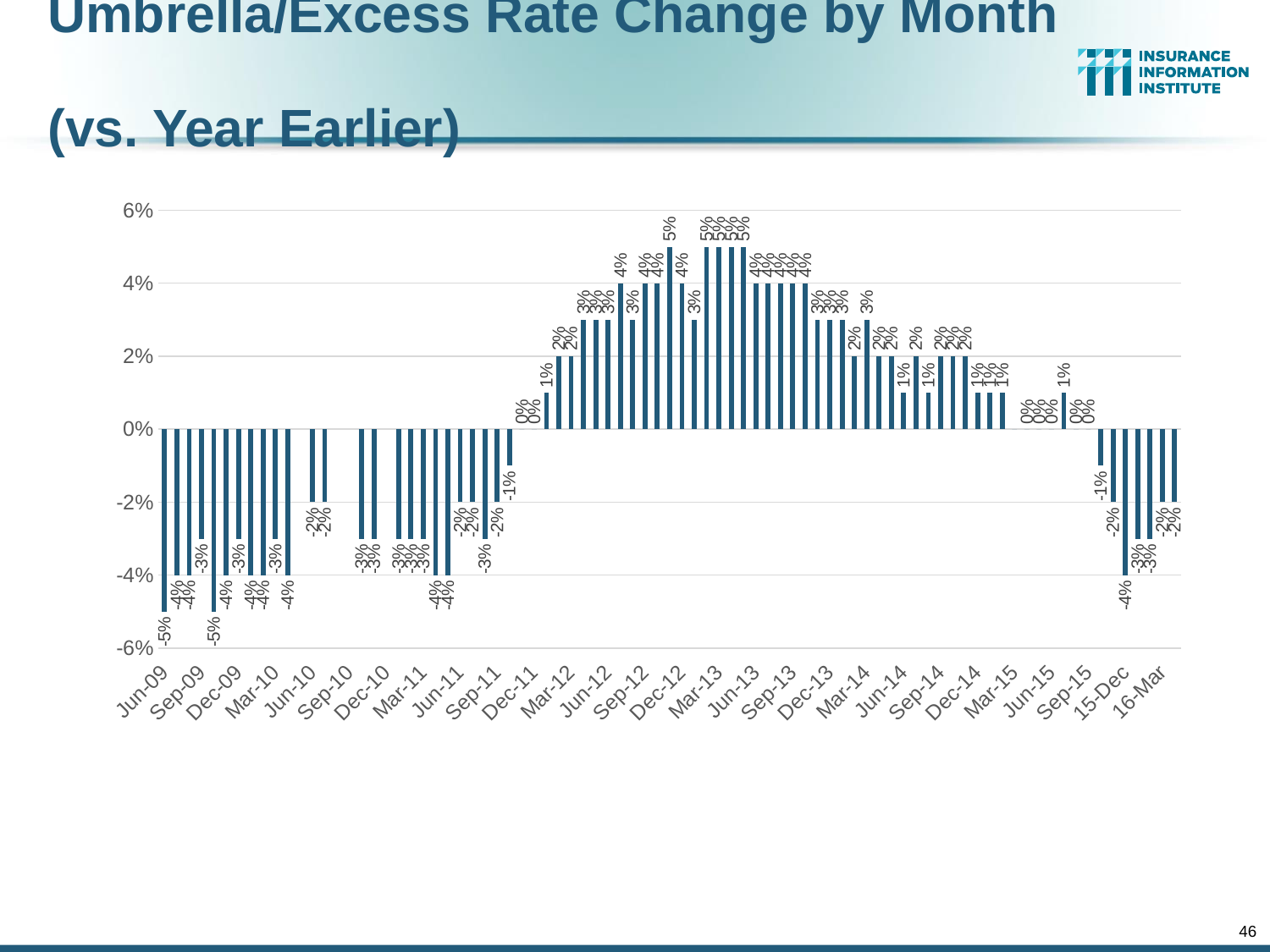
What are the minimum and maximum values shown on the vertical axis? -6% and 6% What is the rate change shown for Jun-09, the first bar on the chart? -5% What is the rate change shown for 16-Mar, the last bar on the chart? -2% Which has the larger rate change, Jun-09 or 16-Mar? 16-Mar What is the lowest rate change value labelled on the chart? -5% What is the title of the chart on the slide? Umbrella/Excess Rate Change by Month (vs. Year Earlier) Is the value for Jun-09 greater or less than -4%? less What kind of chart is shown on the slide? Bar chart What is the difference between the highest labelled value (5%) and the lowest labelled value (-5%) on the chart? 10 percentage points Do the rate changes generally rise or fall from Jun-09 to early 2013? Rise Do the rate changes generally rise or fall from early 2013 to 16-Mar? Fall What is the highest rate change value labelled on the chart? 5%